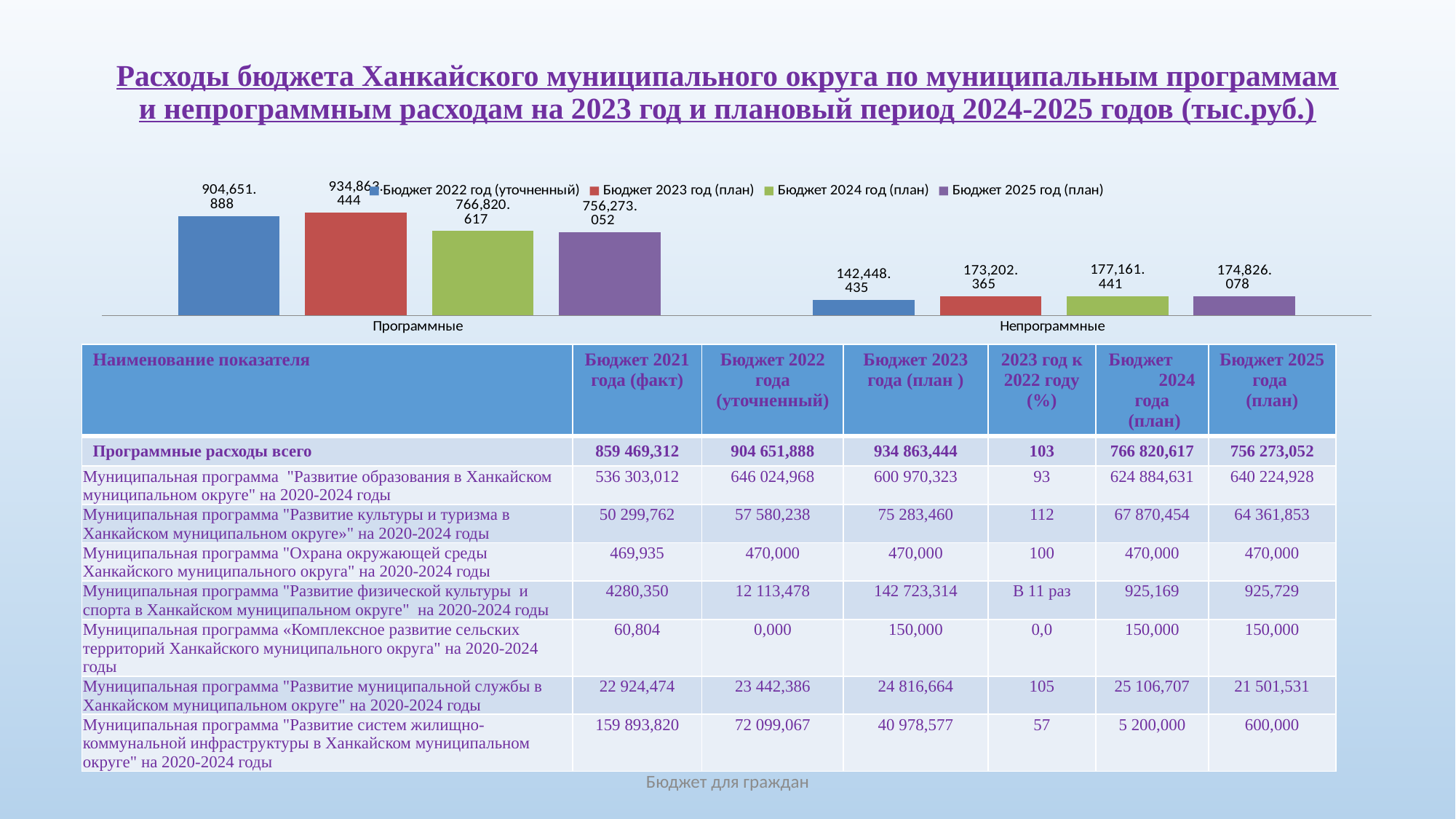
What is the difference between the Бюджет 2024 год (план) and Бюджет 2023 год (план) values for Непрограммные? 3,959.076 How many series does the chart legend list? 4 What is the value of the Бюджет 2024 год (план) bar for Непрограммные? 177,161.441 What is the value of the Бюджет 2025 год (план) bar for Программные? 756,273.052 What is the value of the Бюджет 2022 год (уточненный) bar for Программные? 904,651.888 What type of chart is shown on the slide? Bar chart Which series has the lowest value for Непрограммные? Бюджет 2022 год (уточненный) Which series has the highest value for Программные? Бюджет 2023 год (план) What is the value of the Бюджет 2023 год (план) bar for Непрограммные? 173,202.365 Which is larger for Непрограммные: the Бюджет 2024 год (план) value or the Бюджет 2025 год (план) value? Бюджет 2024 год (план) What is the difference between the Бюджет 2023 год (план) and Бюджет 2022 год (уточненный) values for Программные? 30,211.556 How many categories are shown on the x axis of the chart? 2